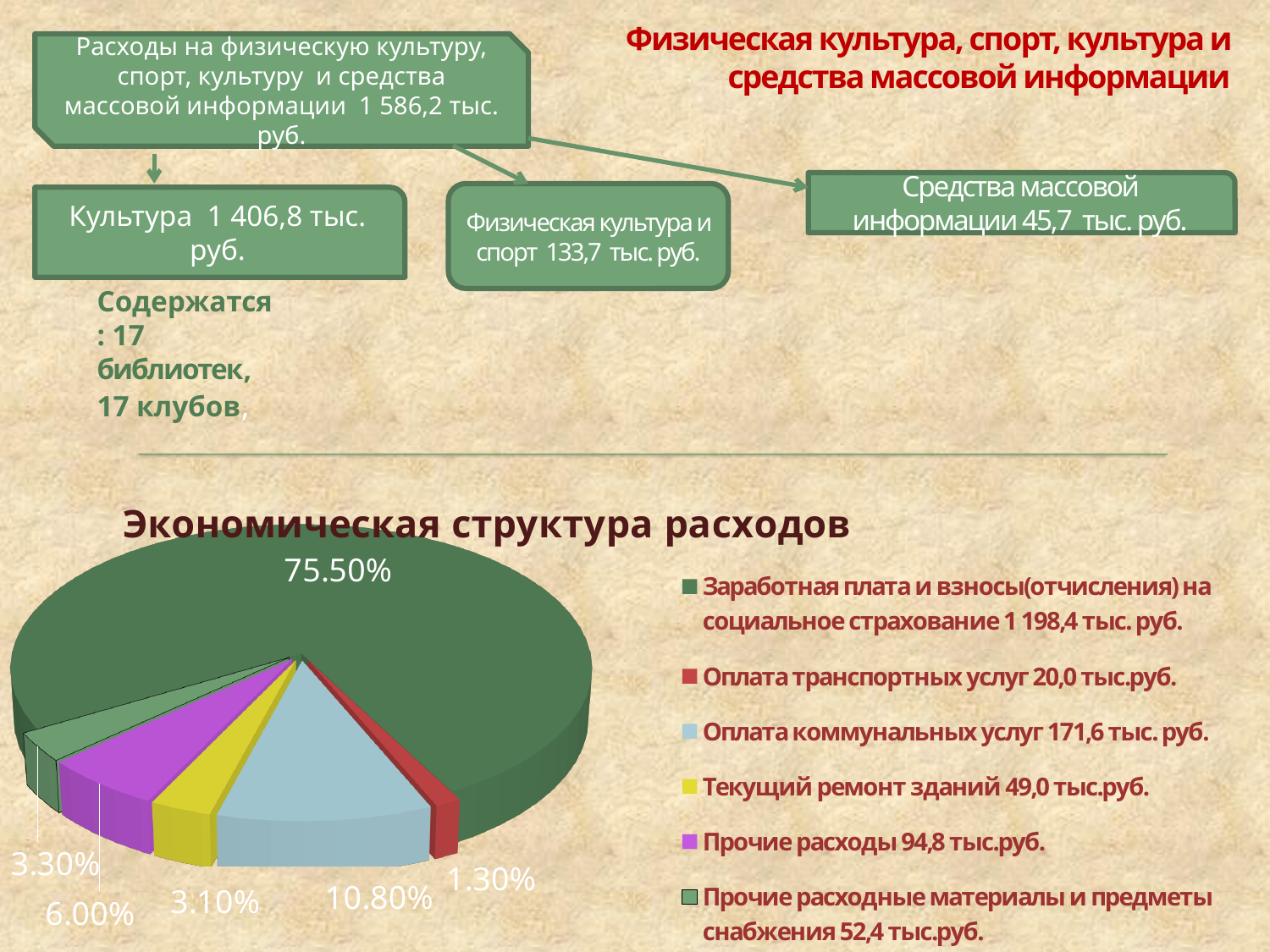
What kind of chart is shown under the title "Экономическая структура расходов"? pie chart What share of the pie does "Прочие расходы" take? 6.00% How many entries does the legend of the pie chart list? 6 What share of the pie does "Заработная плата и взносы(отчисления) на социальное страхование" take? 75.50% Which slice is larger: "Прочие расходы" or "Текущий ремонт зданий"? Прочие расходы Which category has the largest slice in the pie chart? Заработная плата и взносы(отчисления) на социальное страхование How many slices does the pie chart "Экономическая структура расходов" have? 6 What share of the pie does "Оплата транспортных услуг" take? 1.30% Which category has the smallest slice in the pie chart? Оплата транспортных услуг What colour is the slice for "Оплата коммунальных услуг" in the pie chart? light blue What is the difference in percentage points between the "Оплата коммунальных услуг" slice and the "Прочие расходы" slice? 4.80%